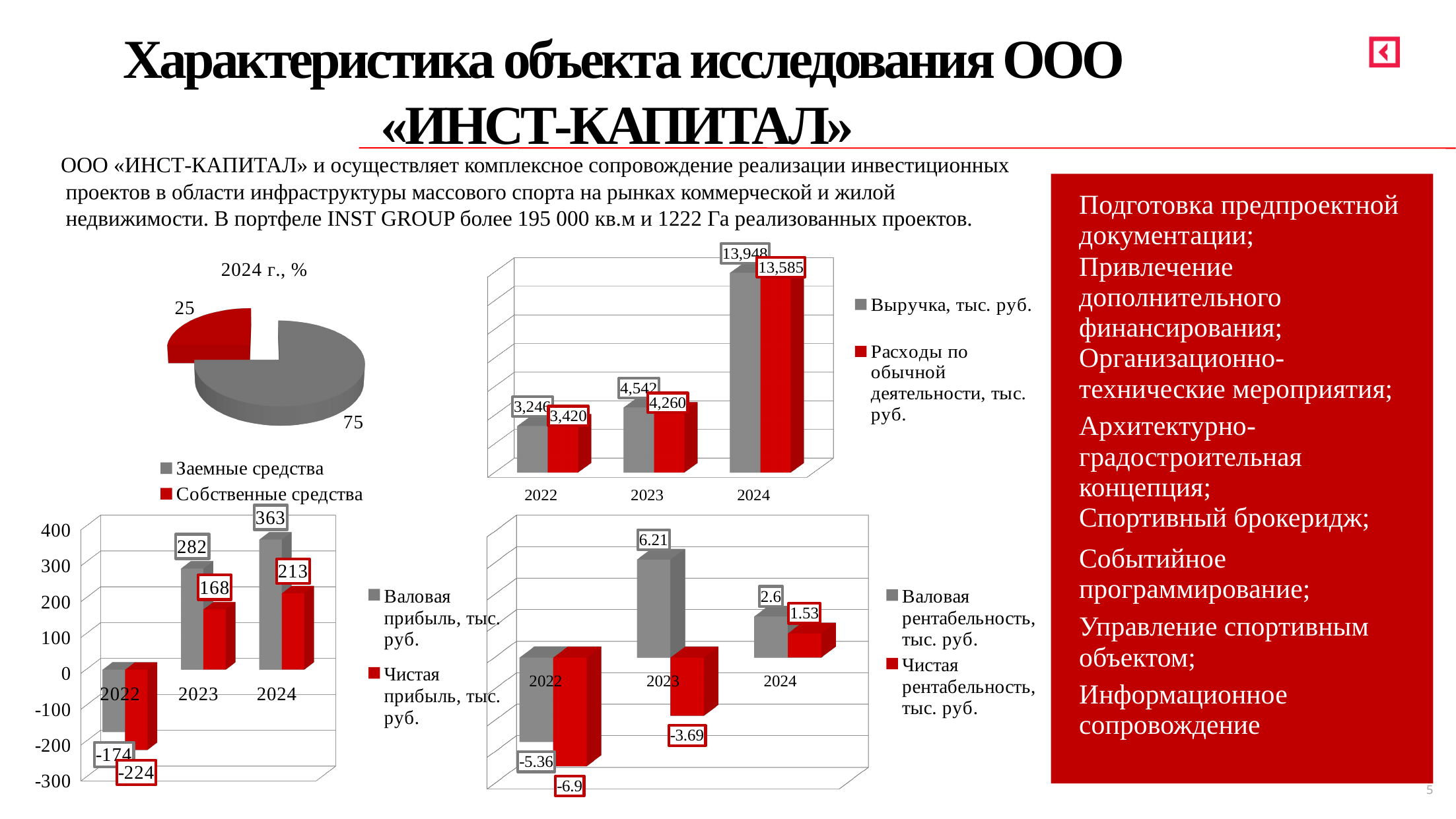
In the bottom-left bar chart (Валовая прибыль / Чистая прибыль), what is the value of "Чистая прибыль, тыс. руб." for 2022? -224 In the bottom-left bar chart (Валовая прибыль / Чистая прибыль), does "Валовая прибыль" rise or fall from 2022 to 2024? rise In the top-right bar chart (Выручка / Расходы), which year has the highest "Выручка, тыс. руб."? 2024 How many series does the legend of the bottom-middle bar chart (рентабельность) list? 2 In the top-right bar chart (Выручка / Расходы), what is the value of "Выручка, тыс. руб." for 2024? 13,948 In the top-right bar chart (Выручка / Расходы), what is the value of "Расходы по обычной деятельности, тыс. руб." for 2022? 3,420 In the bottom-middle bar chart (Валовая рентабельность / Чистая рентабельность), which is larger in 2024: "Валовая рентабельность" or "Чистая рентабельность"? Валовая рентабельность In the pie chart titled "2024 г., %", what share does "Собственные средства" have? 25 In the bottom-left bar chart (Валовая прибыль / Чистая прибыль), which year has the lowest "Валовая прибыль, тыс. руб."? 2022 In the top-right bar chart (Выручка / Расходы), what is the difference between "Выручка" and "Расходы" in 2023? 282 In the pie chart titled "2024 г., %", what share does "Заемные средства" have? 75 In the bottom-middle bar chart (Валовая рентабельность / Чистая рентабельность), what is the value of "Чистая рентабельность" for 2023? -3.69